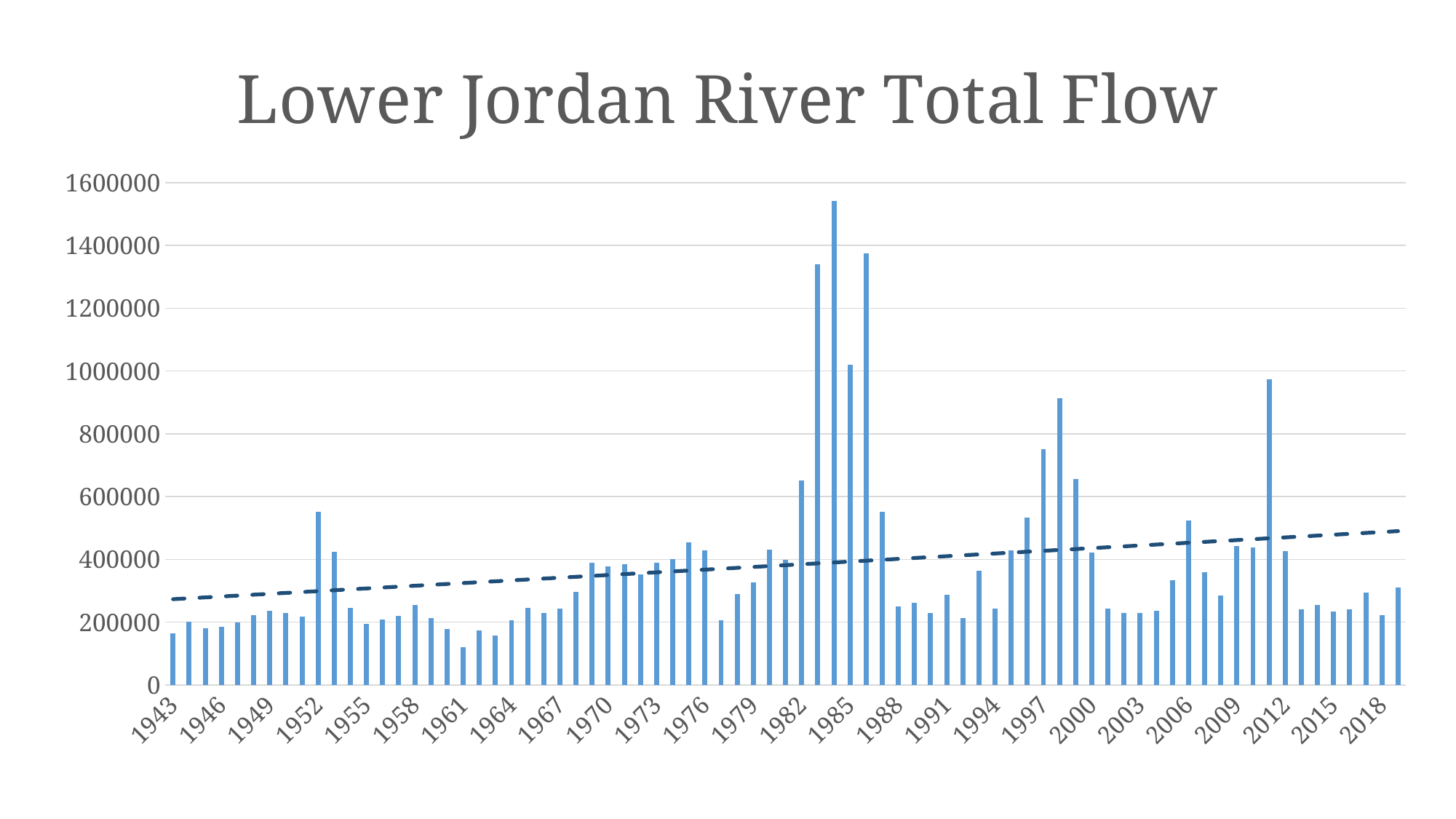
Is the highest bar on the chart greater or less than 1400000? greater Is the value for 2006 greater or less than 400000? greater What kind of chart is shown on the slide? bar chart Is the value for 1943 greater or less than 200000? less What is the first year shown on the x axis? 1943 Does the dashed trend line rise or fall from 1943 to 2018? rises What is the title of the chart? Lower Jordan River Total Flow Which year has the lowest total flow? 1961